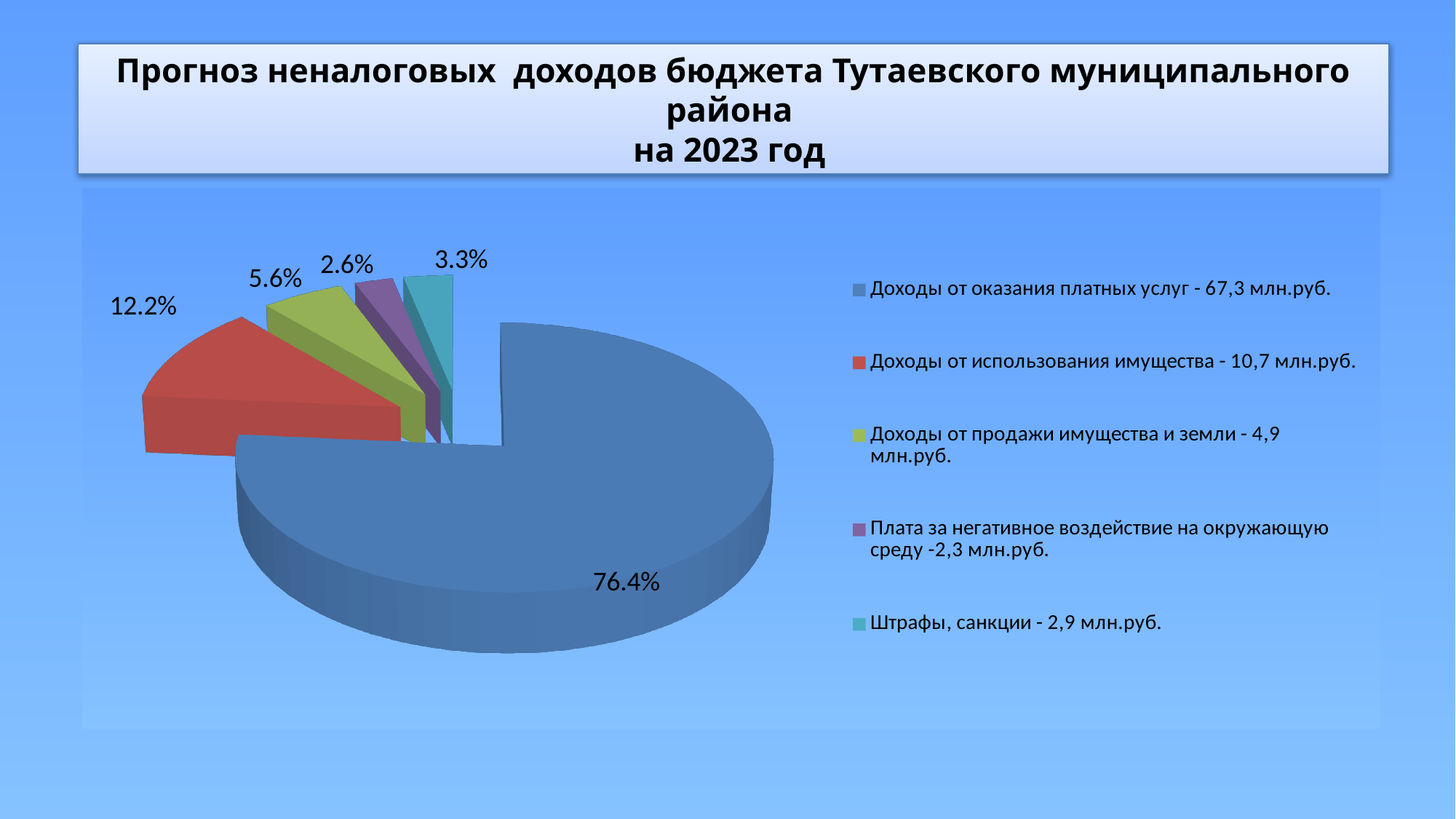
What share of the pie does "Доходы от оказания платных услуг" take? 76.4% According to the legend, what amount in млн.руб. corresponds to "Доходы от оказания платных услуг"? 67,3 млн.руб. What is the difference in percentage points between the "Доходы от использования имущества" slice and the "Доходы от продажи имущества и земли" slice? 6.6 Which category has the largest slice of the pie? Доходы от оказания платных услуг What share of the pie does "Плата за негативное воздействие на окружающую среду" take? 2.6% Which category has the smallest slice of the pie? Плата за негативное воздействие на окружающую среду How many slices does the pie chart have? 5 What kind of chart is shown on the slide? Pie chart What share of the pie does "Доходы от использования имущества" take? 12.2% Which slice is larger: "Штрафы, санкции" or "Плата за негативное воздействие на окружающую среду"? Штрафы, санкции